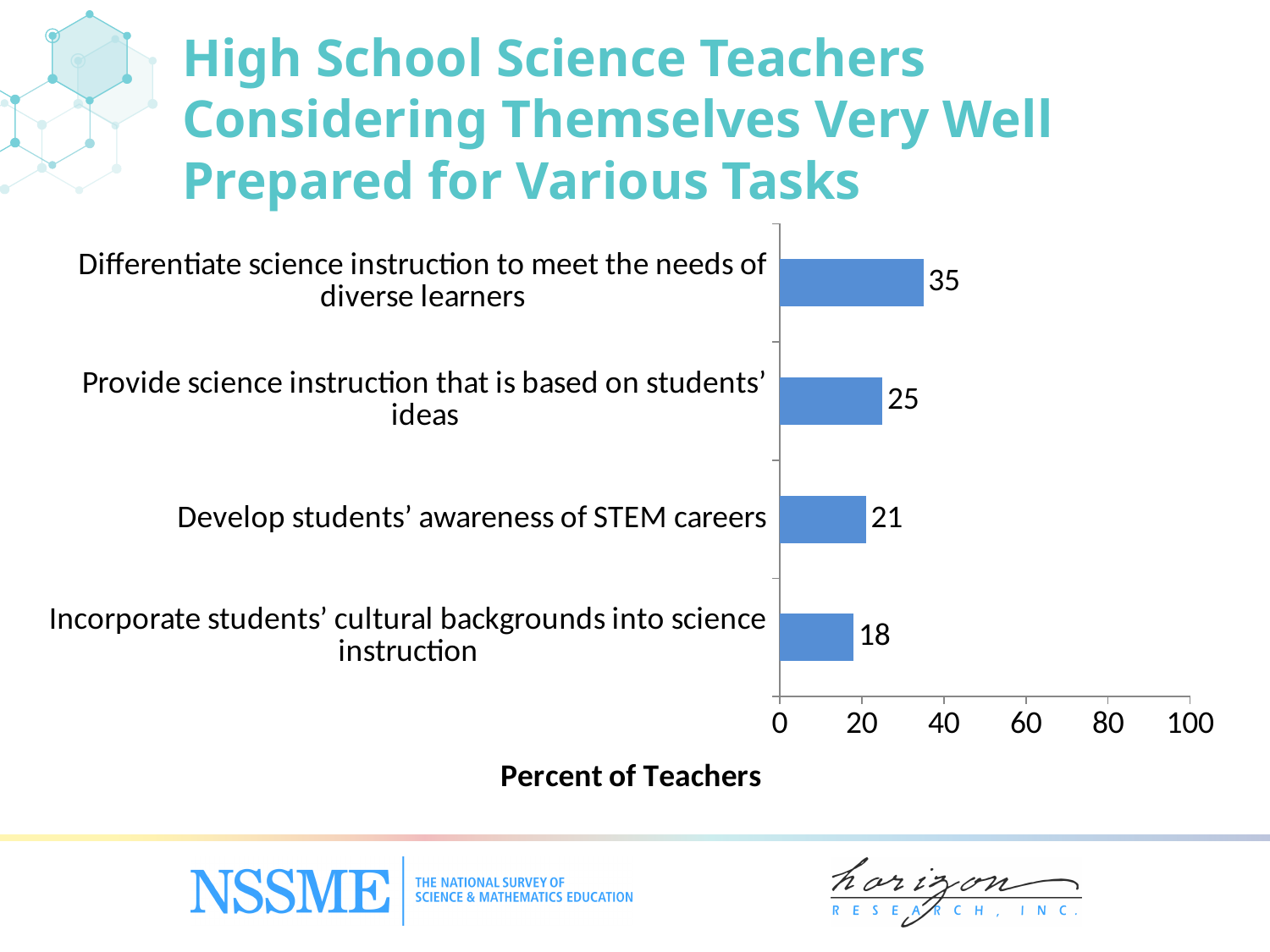
Is the value for "Develop students' awareness of STEM careers" greater or less than 40? less How many tasks are shown in the chart? 4 What is the value for "Develop students' awareness of STEM careers"? 21 What is the label of the horizontal axis? Percent of Teachers What kind of chart is shown on the slide? Bar chart Which is larger: the value for providing instruction based on students' ideas or the value for developing students' awareness of STEM careers? Provide science instruction that is based on students' ideas What is the value for "Provide science instruction that is based on students' ideas"? 25 What is the difference between the values for differentiating science instruction for diverse learners and incorporating students' cultural backgrounds? 17 What is the value for "Incorporate students' cultural backgrounds into science instruction"? 18 What percent of high school science teachers consider themselves very well prepared to differentiate science instruction to meet the needs of diverse learners? 35 Which task has the highest percent of teachers considering themselves very well prepared? Differentiate science instruction to meet the needs of diverse learners Which task has the lowest percent of teachers considering themselves very well prepared? Incorporate students' cultural backgrounds into science instruction